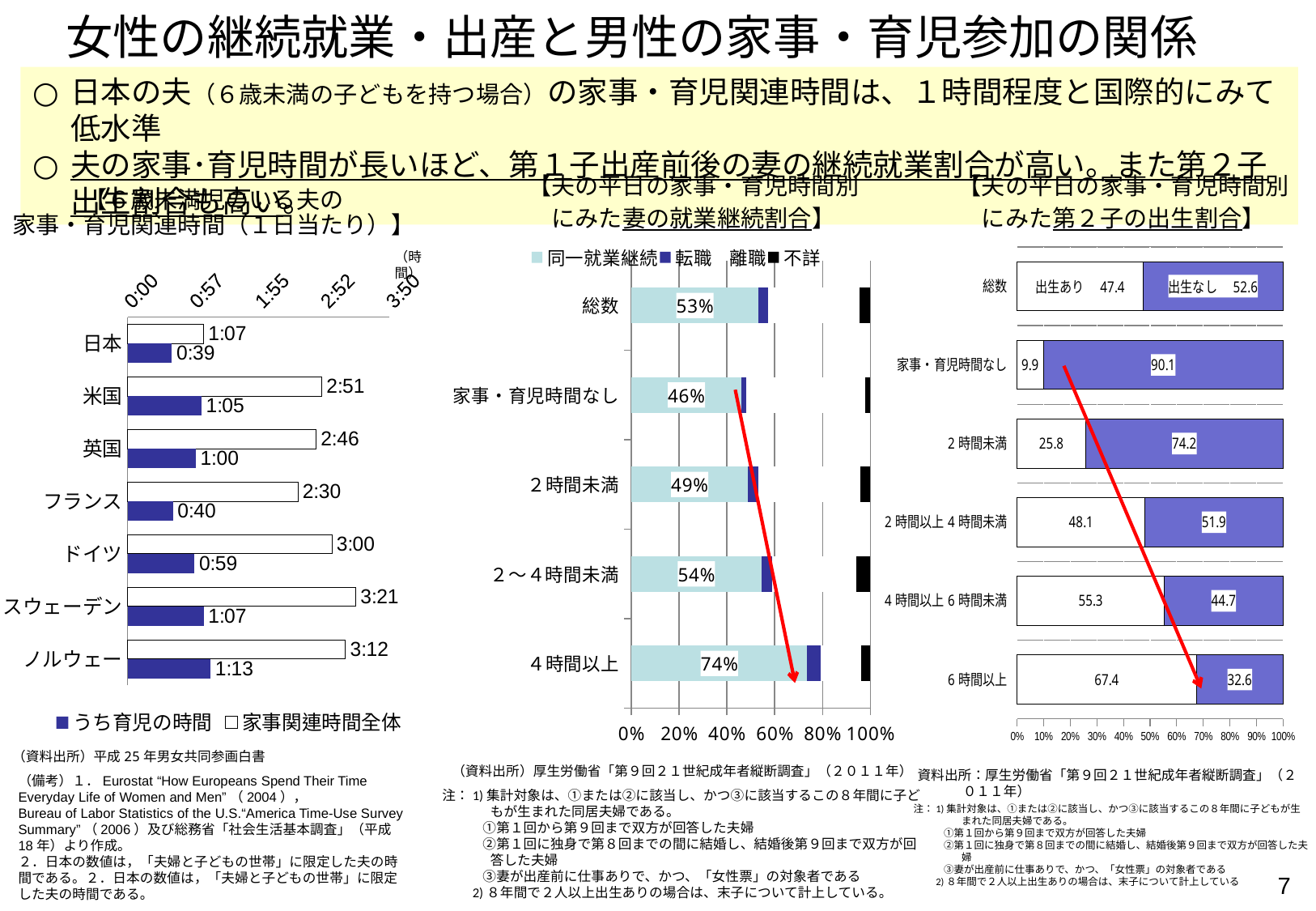
In the left chart of husbands' housework and childcare time by country, which country has the highest total housework-related time (家事関連時間全体)? スウェーデン In the left chart of husbands' housework and childcare time by country, what is the total housework-related time (家事関連時間全体) for 日本? 1:07 In the middle chart of wives' employment continuation by husbands' weekday housework/childcare time, how many series does the legend list? 4 In the right chart of second-child birth rates by husbands' weekday housework/childcare time, what is the difference between the 出生なし values for 家事・育児時間なし and 6時間以上? 57.5 In the left chart of husbands' housework and childcare time by country, which country has the lowest childcare time (うち育児の時間)? 日本 In the middle chart of wives' employment continuation by husbands' weekday housework/childcare time, what is the 同一就業継続 share for 4時間以上? 74% What kind of chart is the right chart of second-child birth rates by husbands' weekday housework/childcare time? Stacked bar chart In the left chart of husbands' housework and childcare time by country, what is the childcare time (うち育児の時間) for ノルウェー? 1:13 In the middle chart of wives' employment continuation by husbands' weekday housework/childcare time, which category has the lowest 同一就業継続 share? 家事・育児時間なし In the left chart of husbands' housework and childcare time by country, is the total housework-related time for ドイツ greater or less than that for フランス? greater In the right chart of second-child birth rates by husbands' weekday housework/childcare time, what is the 出生あり value for 6時間以上? 67.4 In the left chart of husbands' housework and childcare time by country, how many countries are shown? 7